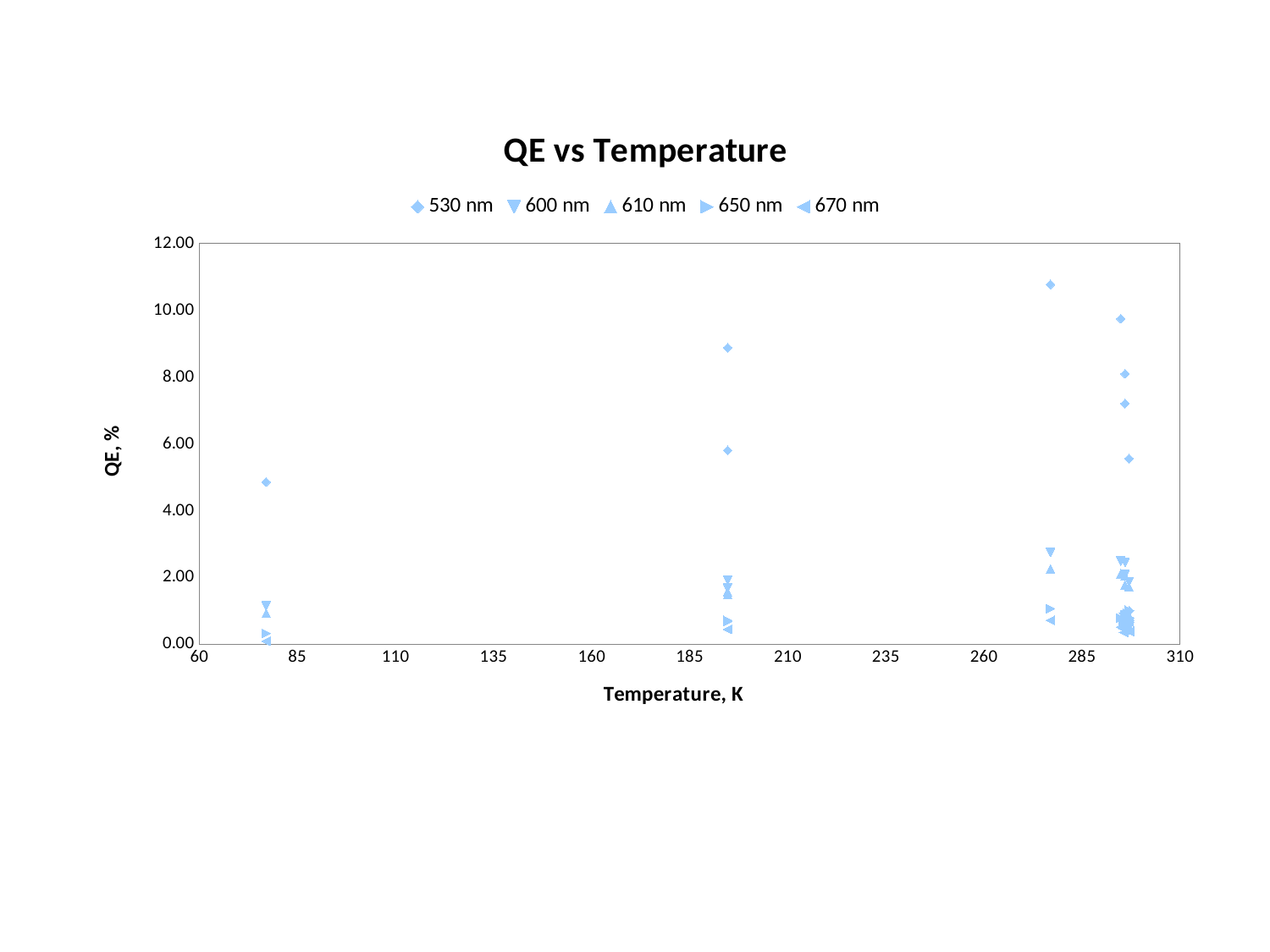
What is the label of the x axis? Temperature, K Are all the 600 nm points greater or less than 4.00? less What kind of chart is shown on the slide? scatter chart What is the title of the chart? QE vs Temperature Which series reaches the highest QE values on the chart? 530 nm How many series does the legend list? 5 Is the highest 530 nm point near 195 K greater or less than 8.00? greater Is the highest 530 nm point near 275 K greater or less than 10.00? greater Near 275 K, which series has the larger QE value: 530 nm or 600 nm? 530 nm Do the highest 530 nm values generally rise or fall as temperature increases from 78 K to 275 K? rise